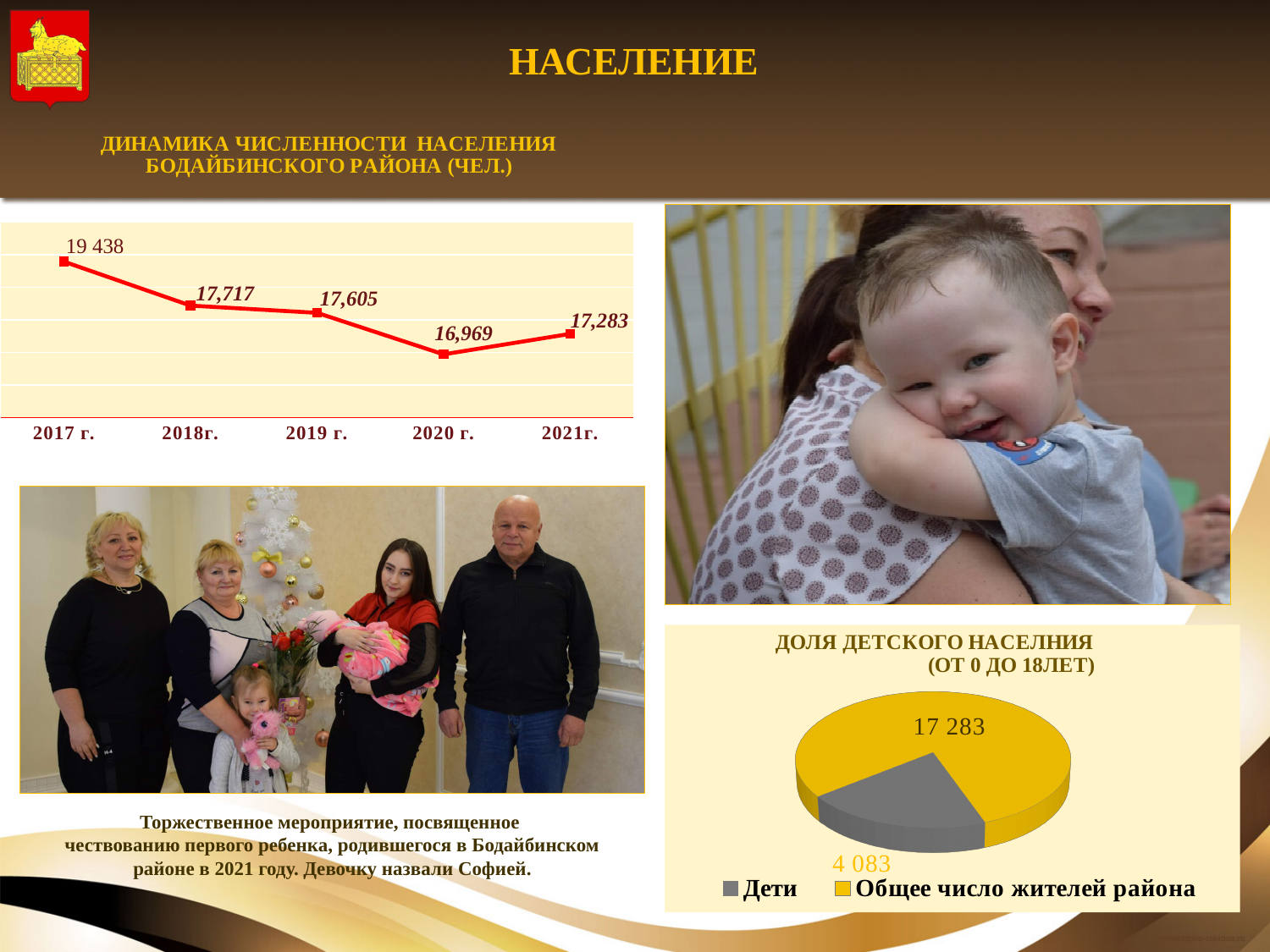
On the line chart of population dynamics, what is the value for 2020 г.? 16,969 On the line chart of population dynamics, which year has the highest value? 2017 г. On the pie chart of the share of child population, what is the value for Дети? 4 083 On the line chart of population dynamics, what is the value for 2017 г.? 19 438 On the line chart of population dynamics, what is the value for 2021г.? 17,283 On the line chart of population dynamics, which year has the lowest value? 2020 г. On the line chart of population dynamics, which is larger, the value for 2018г. or the value for 2021г.? 2018г. How many entries does the legend of the pie chart of the share of child population list? 2 How many years are plotted on the line chart of population dynamics? 5 On the line chart of population dynamics, what is the difference between the 2019 г. and 2020 г. values? 636 What kind of chart is the population dynamics chart on the left? line chart On the line chart of population dynamics, do the values rise or fall from 2017 г. to 2020 г.? fall